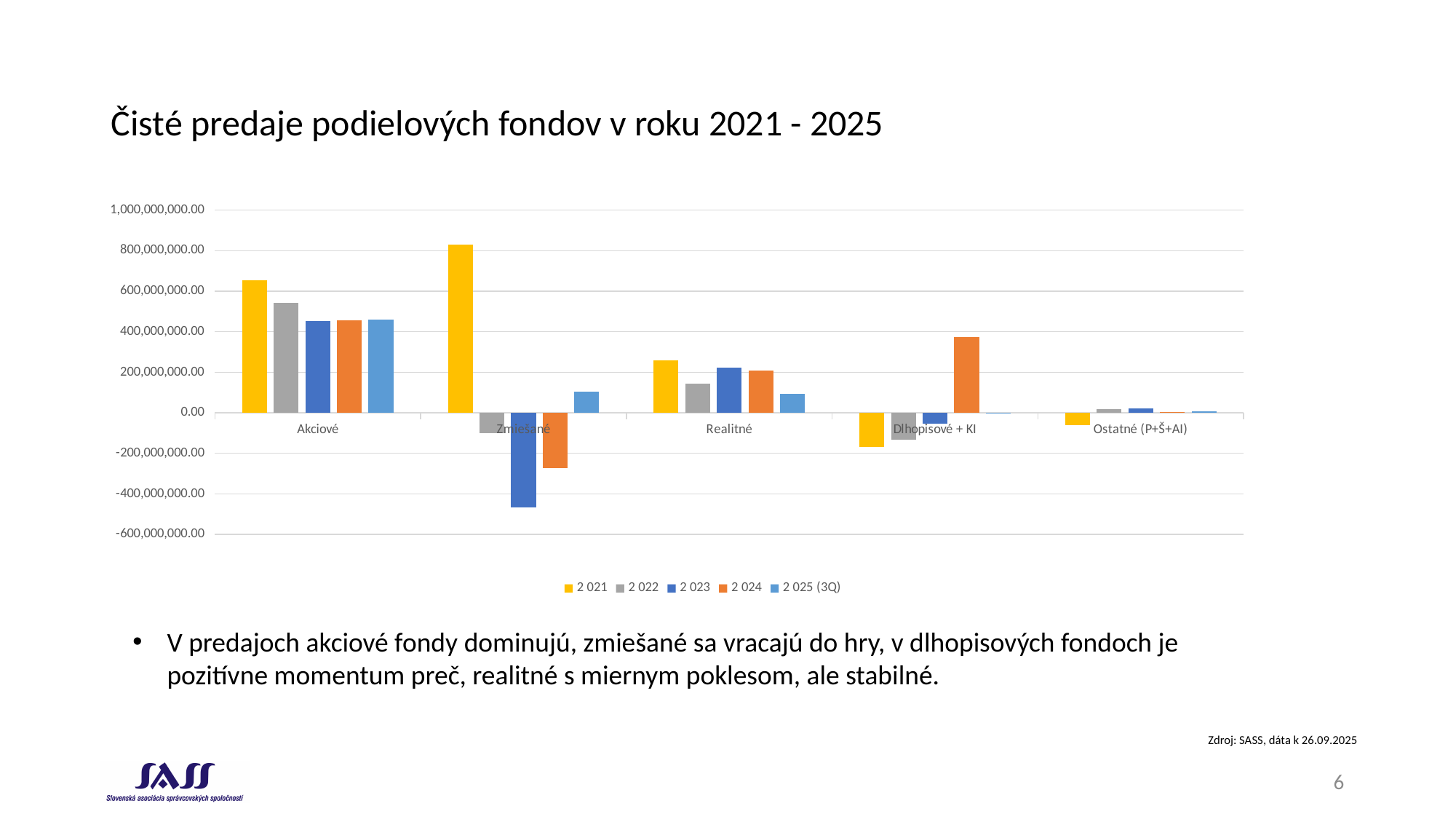
For the 2 022 series, which category has the larger value: Akciové or Realitné? Akciové How many fund categories are shown on the x axis? 5 What is the label of the last series in the legend? 2 025 (3Q) Which category has the lowest value for the 2 023 series? Zmiešané What kind of chart is shown on the slide? bar chart For Realitné, which series has the larger value: 2 021 or 2 022? 2 021 Is the 2 024 value for Dlhopisové + KI greater or less than 200,000,000.00? greater Is the 2 021 value for Akciové greater or less than 600,000,000.00? greater What is the title of the slide's chart? Čisté predaje podielových fondov v roku 2021 - 2025 Is the 2 023 value for Zmiešané greater or less than -400,000,000.00? less How many series does the legend list? 5 Which category has the highest value for the 2 021 series? Zmiešané